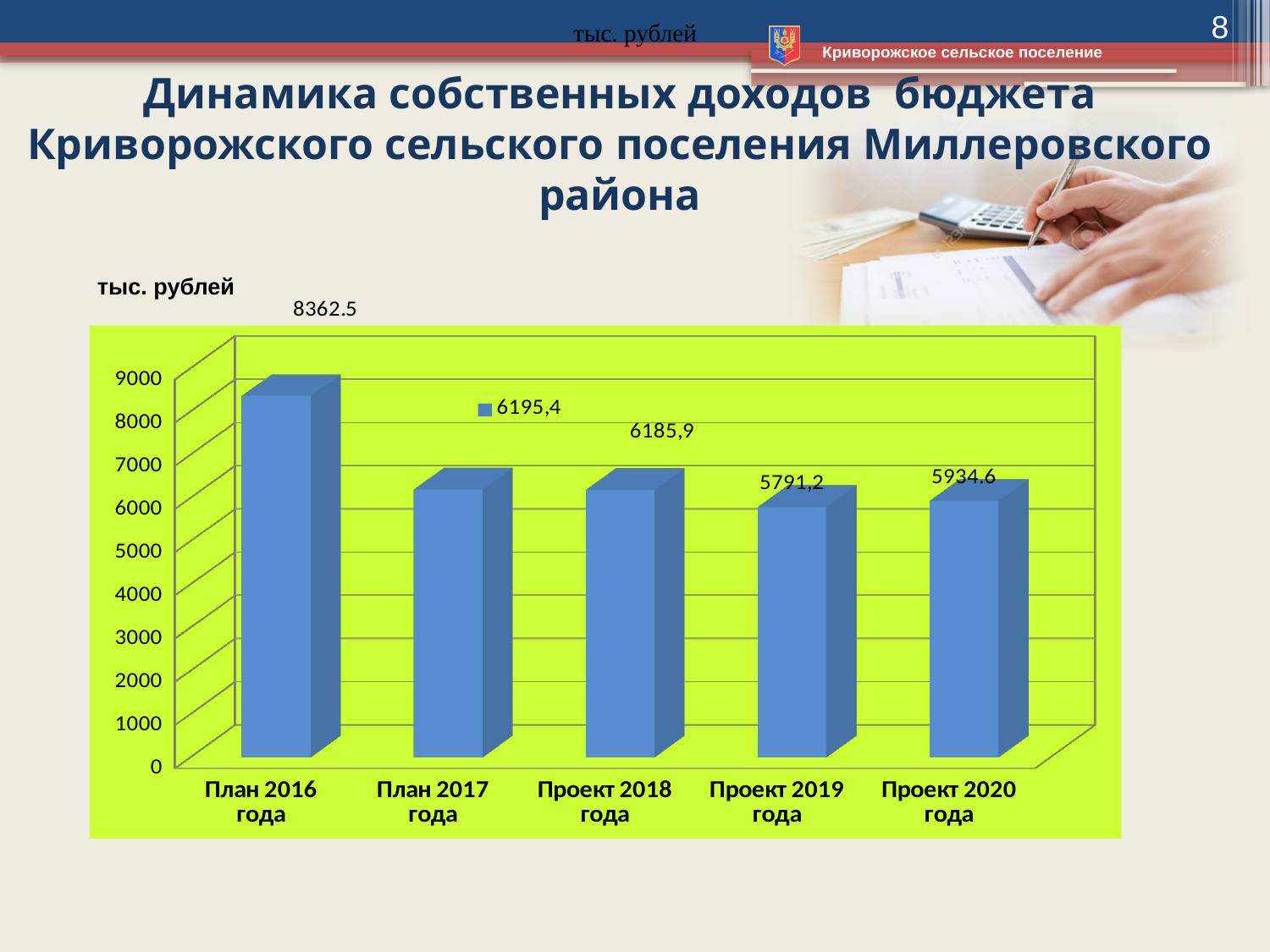
How many categories are shown on the x axis? 5 What is the value for План 2017 года? 6195,4 Which category has the lowest value? Проект 2019 года Which category has the highest value? План 2016 года What kind of chart is shown on the slide? bar chart What is the value for План 2016 года? 8362.5 What unit is indicated above the chart's vertical axis? тыс. рублей What is the difference between the values for План 2016 года and Проект 2020 года? 2427.9 What is the value for Проект 2019 года? 5791,2 Is the value for План 2016 года greater or less than 8000? greater What is the value for Проект 2020 года? 5934.6 Which is larger, the value for Проект 2019 года or Проект 2020 года? Проект 2020 года